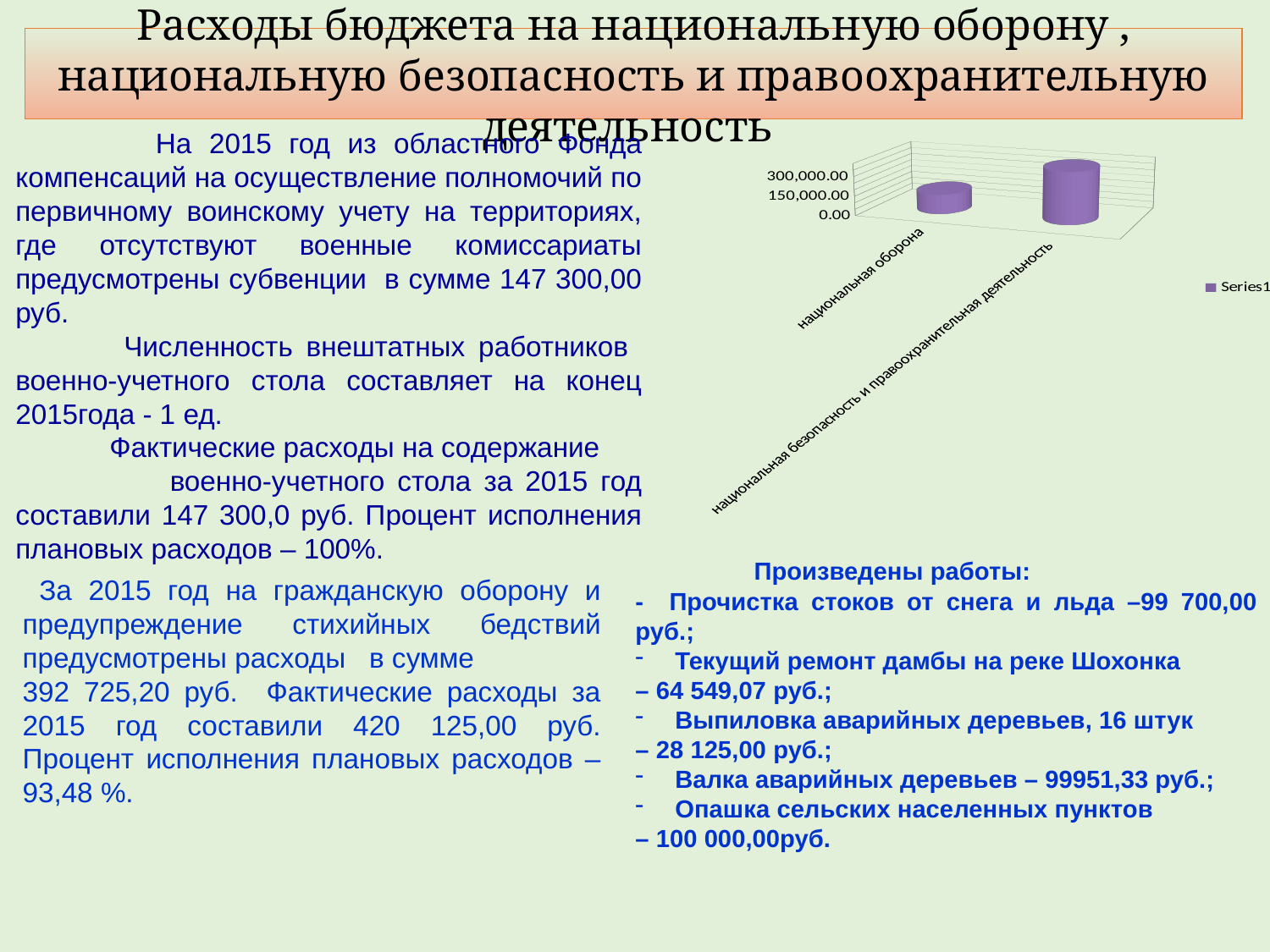
Is the value for национальная оборона greater or less than 300,000.00? less What kind of chart is shown on the slide? bar chart Which category has the lowest bar in the chart? национальная оборона How many categories are plotted in the chart? 2 How many series does the chart legend list? 1 What is the highest tick value shown on the chart's value axis? 300,000.00 Which bar is taller: национальная оборона or национальная безопасность и правоохранительная деятельность? национальная безопасность и правоохранительная деятельность Which category has the highest bar in the chart? национальная безопасность и правоохранительная деятельность Is the value for национальная безопасность и правоохранительная деятельность greater or less than 300,000.00? greater What is the name of the series shown in the chart legend? Series1